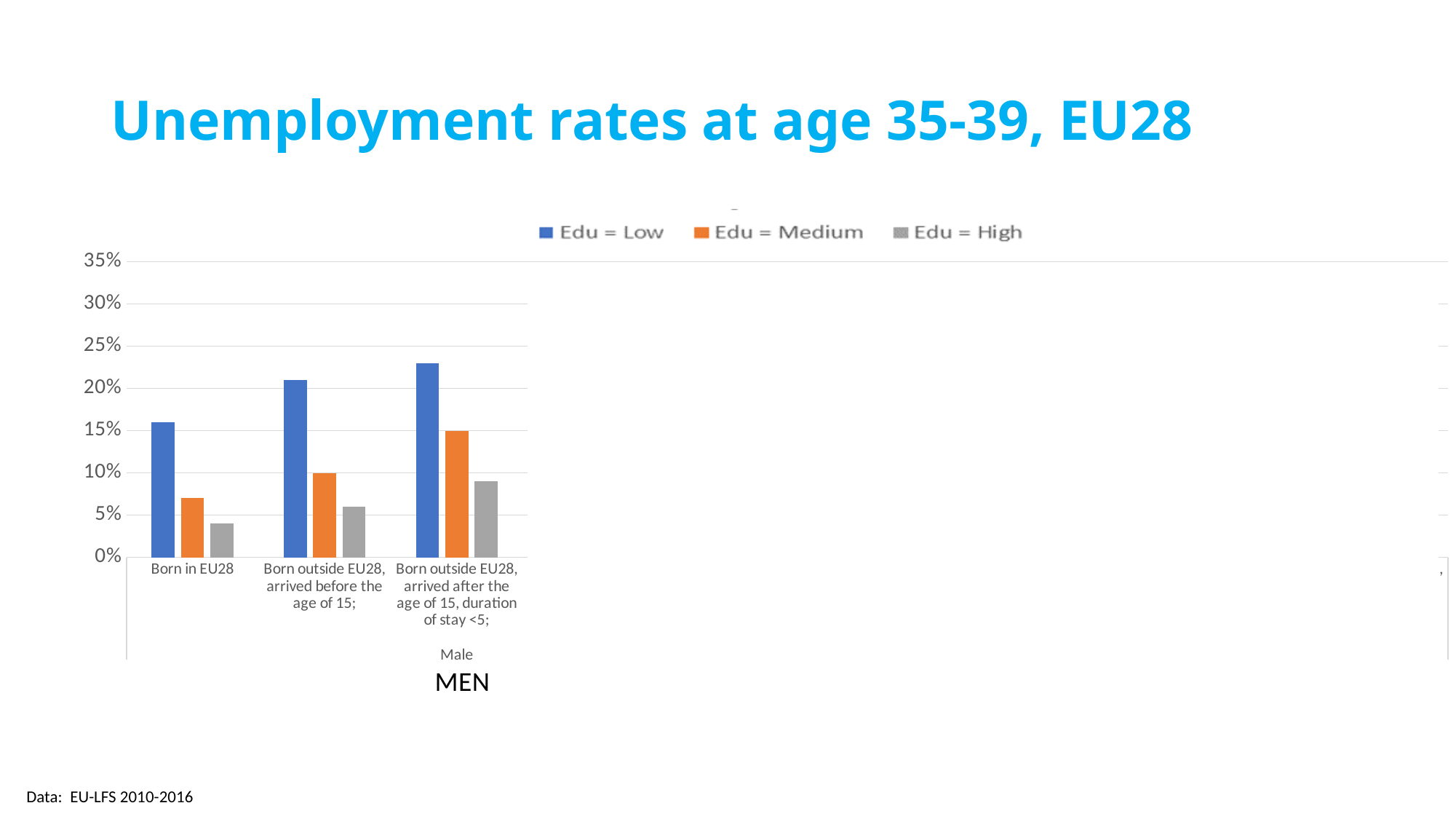
How many categories are shown on the x axis? 3 For Born in EU28, which is larger: the Edu = Low rate or the Edu = Medium rate? Edu = Low Is the Edu = Low value for Born outside EU28, arrived after the age of 15, duration of stay <5 greater or less than 20%? greater Do the Edu = Low values rise or fall moving from Born in EU28 to Born outside EU28, arrived after the age of 15? rise Is the Edu = Medium value for Born outside EU28, arrived after the age of 15, duration of stay <5 greater or less than 10%? greater Is the Edu = Medium value for Born in EU28 greater or less than 10%? less How many series does the legend list? 3 Which colour represents Edu = Medium in the legend? orange What kind of chart is shown on the slide? bar chart Which category has the lowest Edu = High unemployment rate? Born in EU28 Which category has the highest Edu = Low unemployment rate? Born outside EU28, arrived after the age of 15, duration of stay <5